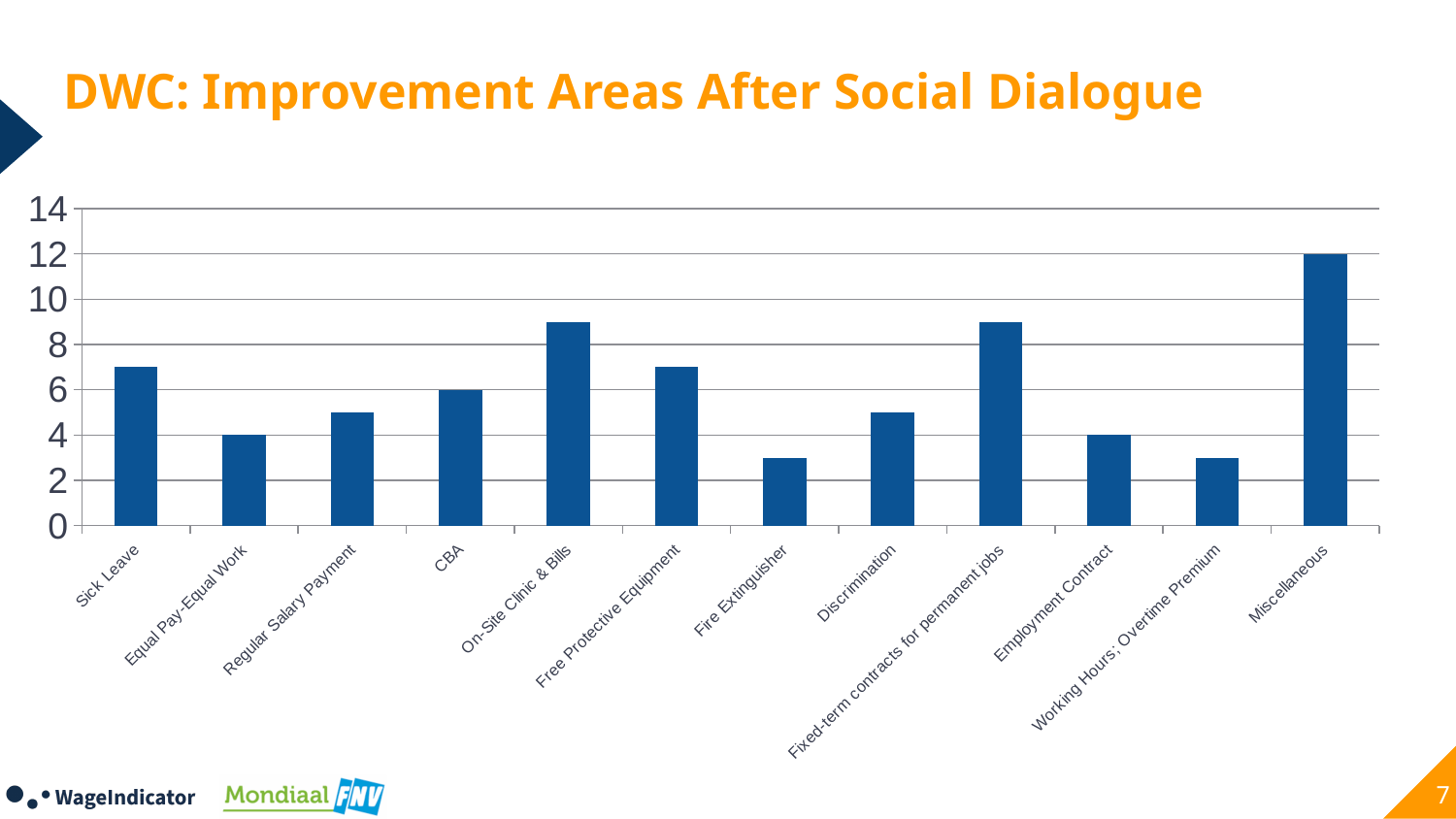
Is the value for Fire Extinguisher greater or less than 4? less What is the value for CBA? 6 How many categories are shown on the x axis of the chart? 12 What is the value for Employment Contract? 4 What is the value for Equal Pay-Equal Work? 4 Which category has the highest value? Miscellaneous What is the value for Miscellaneous? 12 What is the difference between the values for Miscellaneous and CBA? 6 What is the title of the chart? DWC: Improvement Areas After Social Dialogue Which is larger, the value for Fixed-term contracts for permanent jobs or the value for Discrimination? Fixed-term contracts for permanent jobs Is the value for Sick Leave greater or less than 6? greater What type of chart is shown on the slide? Bar chart